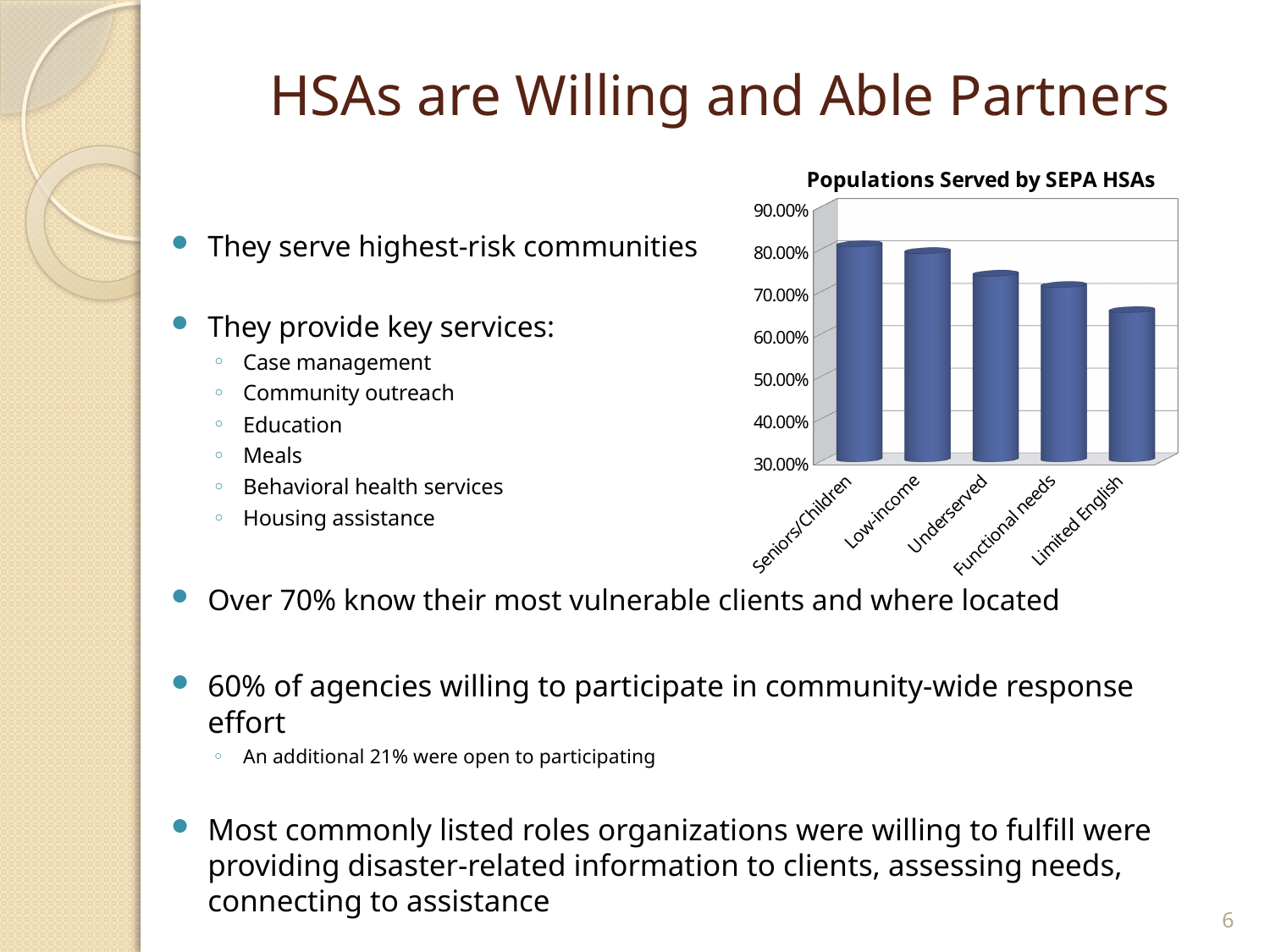
Is the value for Limited English greater or less than 60.00%? greater Is the value for Seniors/Children greater or less than 70.00%? greater What kind of chart is shown on the slide? bar chart Which is larger, the value for Underserved or the value for Limited English? Underserved Which population category has the lowest value in the chart? Limited English Is the value for Underserved greater or less than 70.00%? greater Which is larger, the value for Seniors/Children or the value for Limited English? Seniors/Children Do the values rise or fall moving from left to right across the categories? fall Which population category has the highest value in the chart? Seniors/Children What is the title of the chart on the slide? Populations Served by SEPA HSAs How many population categories are shown in the chart? 5